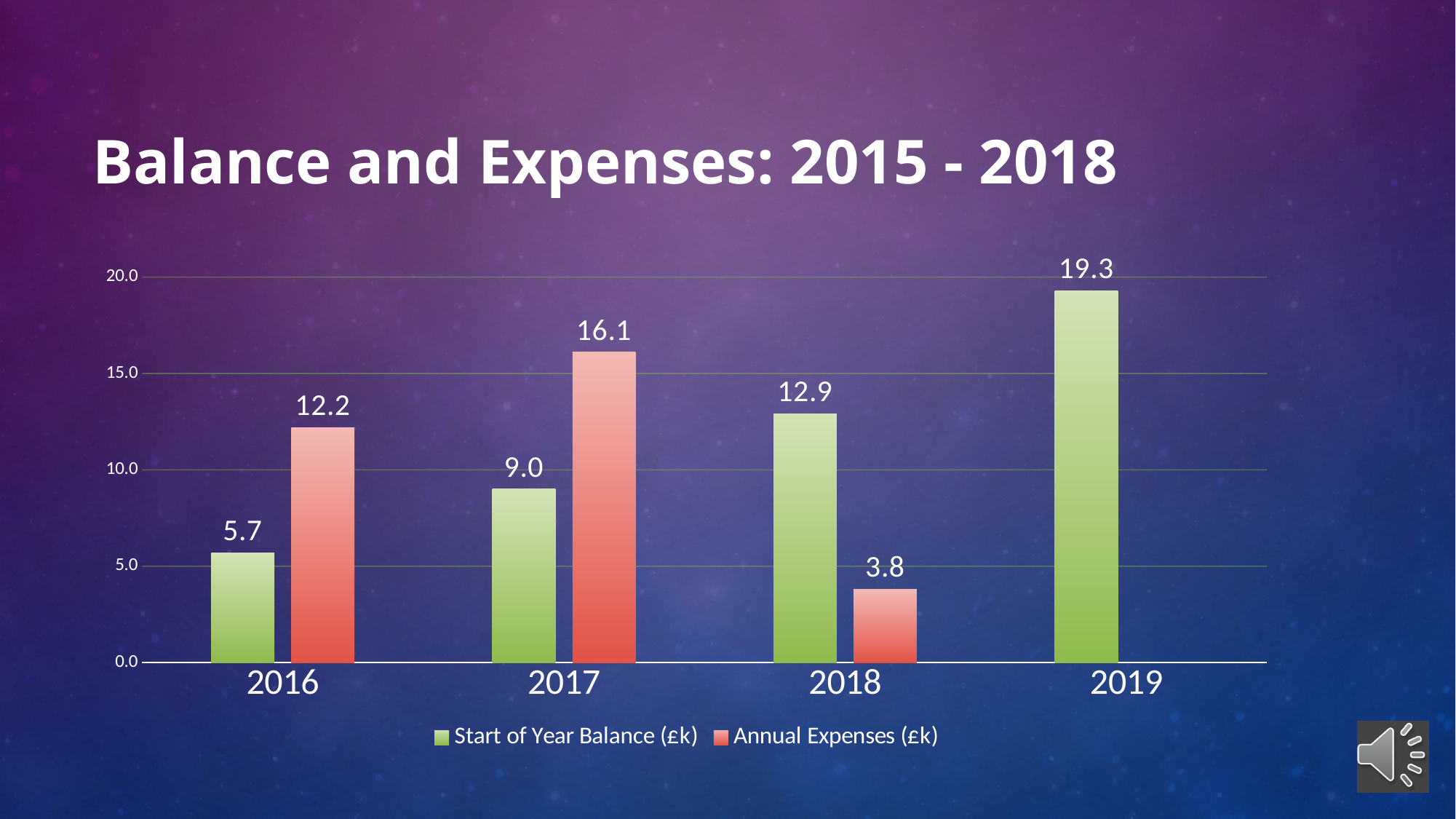
Does the Start of Year Balance (£k) rise or fall from 2016 to 2019? Rise What is the Start of Year Balance (£k) for 2019? 19.3 How many series does the legend list? 2 Which year has the highest Start of Year Balance (£k)? 2019 What is the difference between Annual Expenses (£k) in 2017 and 2018? 12.3 In 2016, which is larger: Start of Year Balance (£k) or Annual Expenses (£k)? Annual Expenses (£k) What is the title of the chart slide? Balance and Expenses: 2015 - 2018 What is the Start of Year Balance (£k) for 2017? 9.0 Which year has the lowest Annual Expenses (£k)? 2018 What kind of chart is shown on the slide? Bar chart How many years are shown on the x axis? 4 What is the Annual Expenses (£k) value for 2016? 12.2